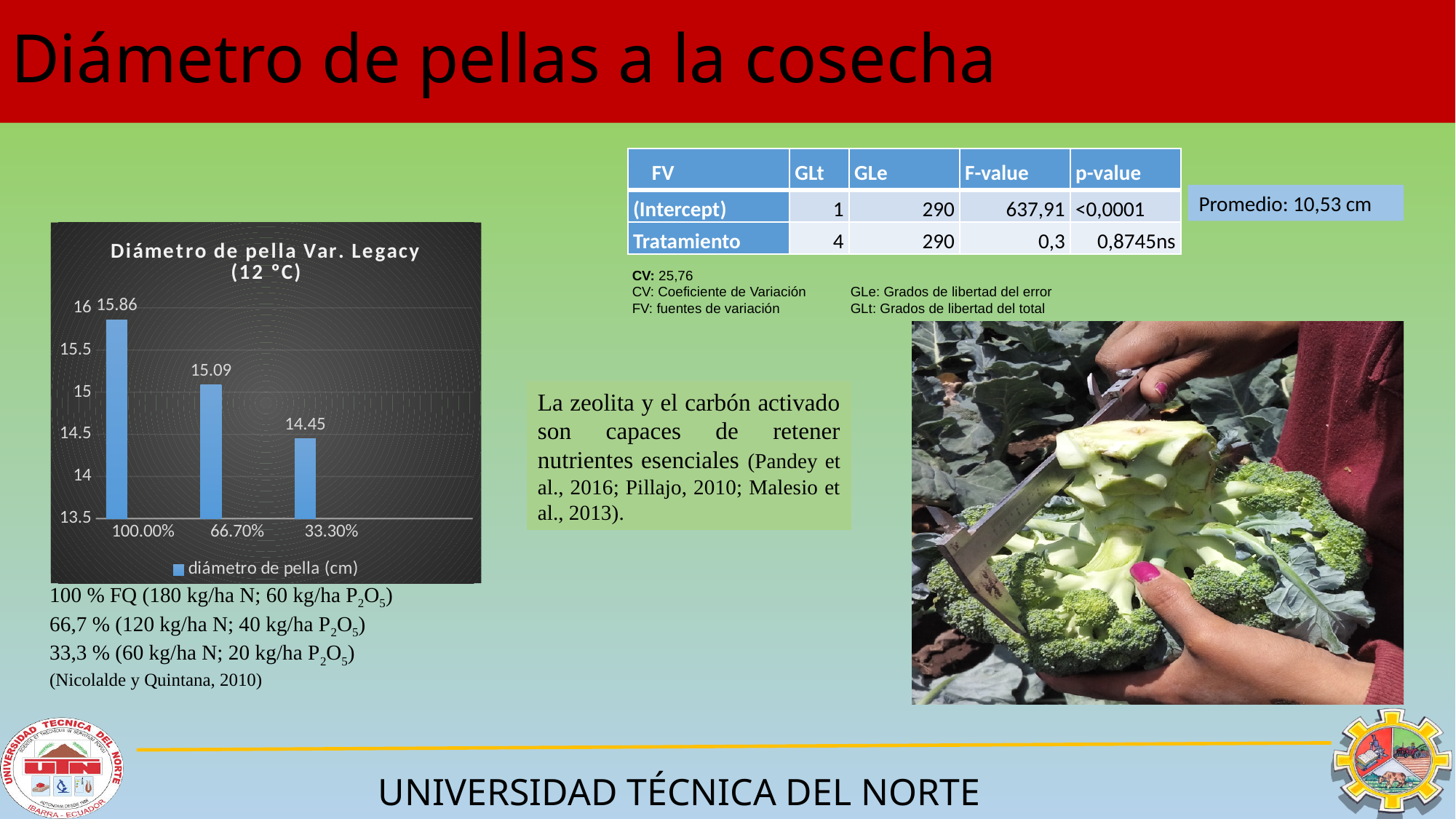
What is the difference between the diámetro de pella for 100.00% and 33.30%? 1.41 Which category has the highest diámetro de pella? 100.00% Which is larger, the diámetro de pella for 66.70% or for 33.30%? 66.70% What is the diámetro de pella (cm) for the 100.00% category? 15.86 Which category has the lowest diámetro de pella? 33.30% What kind of chart is shown on the slide? bar chart What is the difference between the diámetro de pella for 100.00% and 66.70%? 0.77 What is the title of the chart? Diámetro de pella Var. Legacy (12 °C) How many categories are shown in the chart? 3 Is the value for 33.30% greater or less than 15? less What is the diámetro de pella (cm) for the 66.70% category? 15.09 What is the diámetro de pella (cm) for the 33.30% category? 14.45